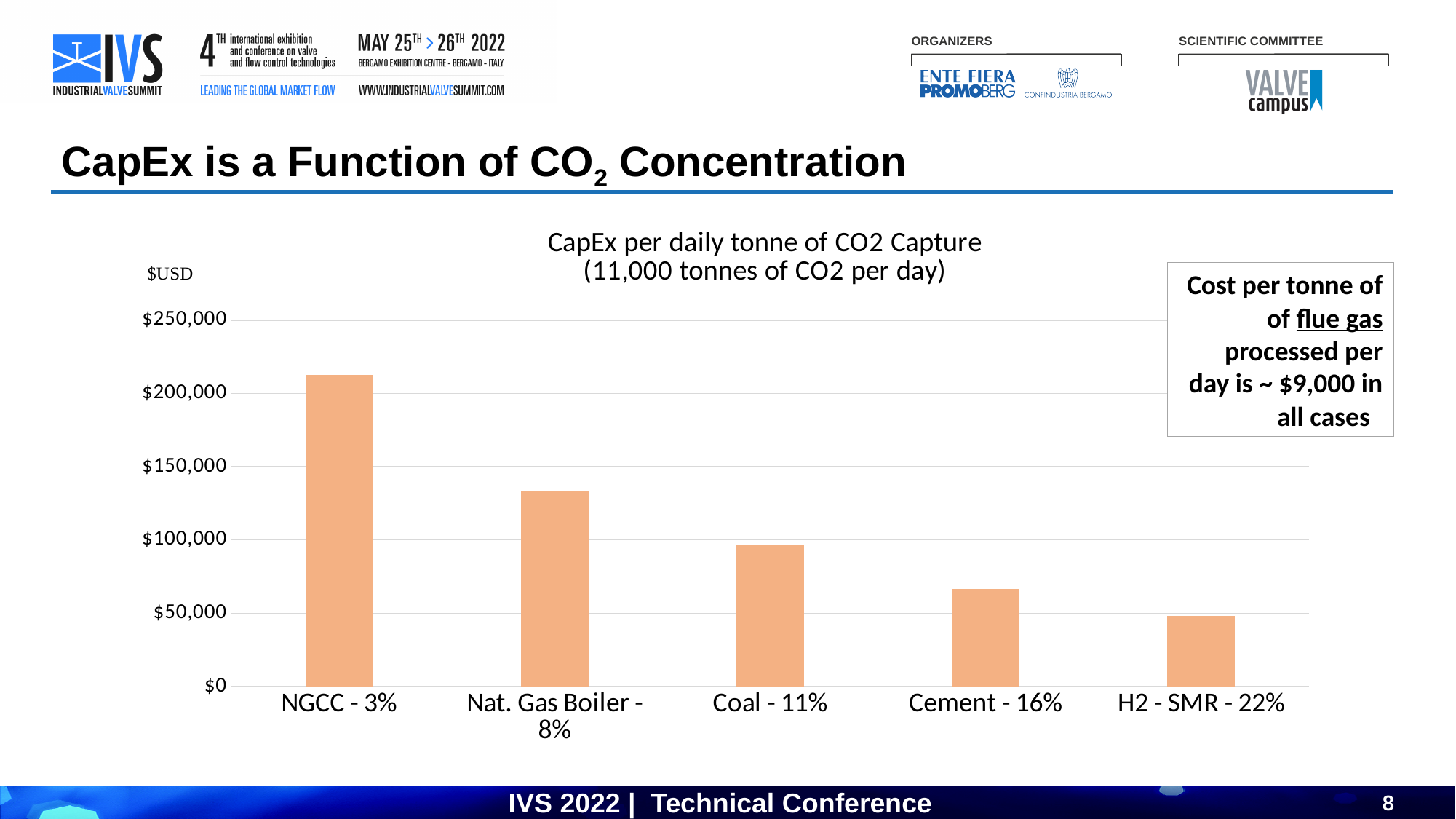
Is the value for NGCC - 3% greater or less than $200,000? greater Is the value for Cement - 16% greater or less than $50,000? greater Which is larger, the value for Coal - 11% or the value for Cement - 16%? Coal - 11% How many categories are plotted in the chart? 5 What is the title of the chart? CapEx per daily tonne of CO2 Capture (11,000 tonnes of CO2 per day) Which category has the lowest CapEx per daily tonne of CO2 capture? H2 - SMR - 22% Is the value for H2 - SMR - 22% greater or less than $100,000? less What kind of chart is shown on the slide? bar chart What unit is shown on the vertical axis of the chart? $USD Do the bar values rise or fall from left to right across the categories? fall Which category has the highest CapEx per daily tonne of CO2 capture? NGCC - 3%